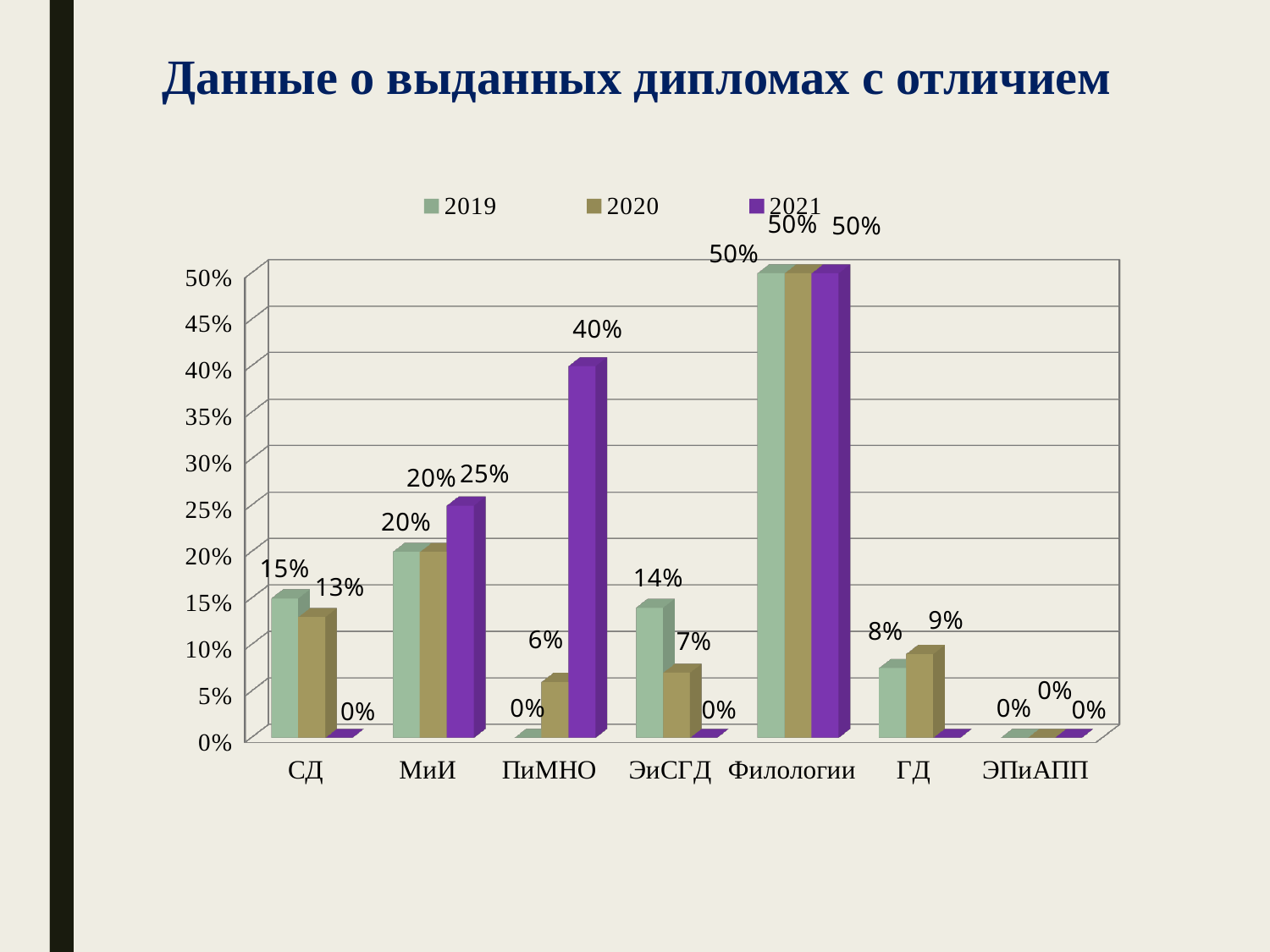
What is the title of the chart? Данные о выданных дипломах с отличием What is the value for ПиМНО in the 2021 series? 40% How many categories are shown on the x axis? 7 What is the value for ГД in the 2019 series? 8% Which is larger for ЭиСГД: the 2019 value or the 2020 value? 2019 What is the difference between the 2021 and 2020 values for ПиМНО? 34% Which category has the lowest value in the 2020 series? ЭПиАПП What kind of chart is shown on the slide? bar chart Which category has the highest value in the 2021 series? Филологии What is the difference between the 2021 and 2019 values for МиИ? 5% What is the value for СД in the 2020 series? 13% How many series does the legend list? 3